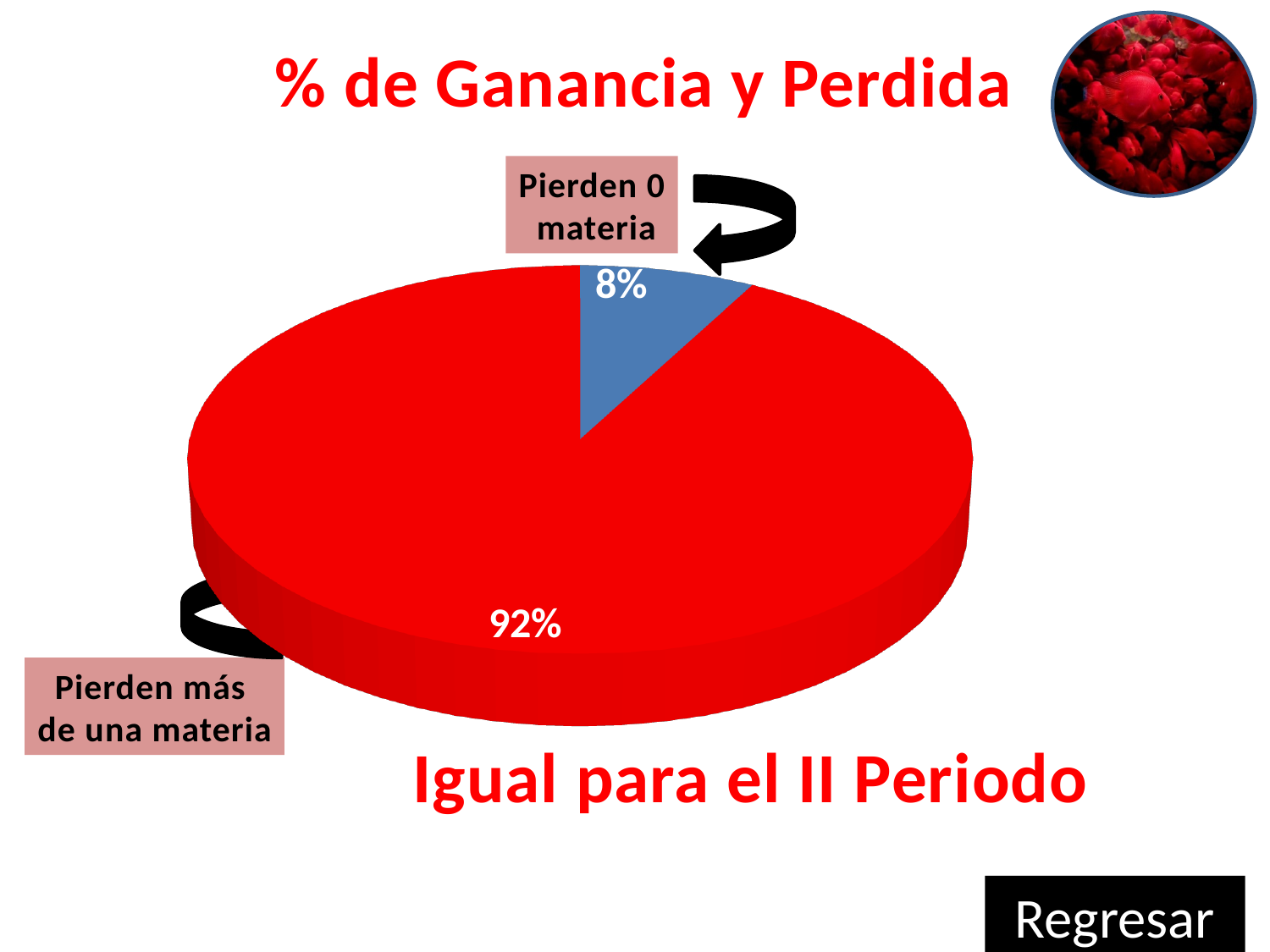
Which slice of the pie is the largest? Pierden más de una materia What kind of chart is shown on the slide? pie chart What is the title of the chart? % de Ganancia y Perdida How many slices does the pie chart have? 2 What percentage is shown for "Pierden más de una materia"? 92% What colour is the "Pierden más de una materia" slice? red What percentage is shown for "Pierden 0 materia"? 8% What share of the pie does the blue slice represent? 8% Which is larger, the "Pierden 0 materia" slice or the "Pierden más de una materia" slice? Pierden más de una materia Which slice of the pie is the smallest? Pierden 0 materia What is the difference in percentage points between the "Pierden más de una materia" slice and the "Pierden 0 materia" slice? 84